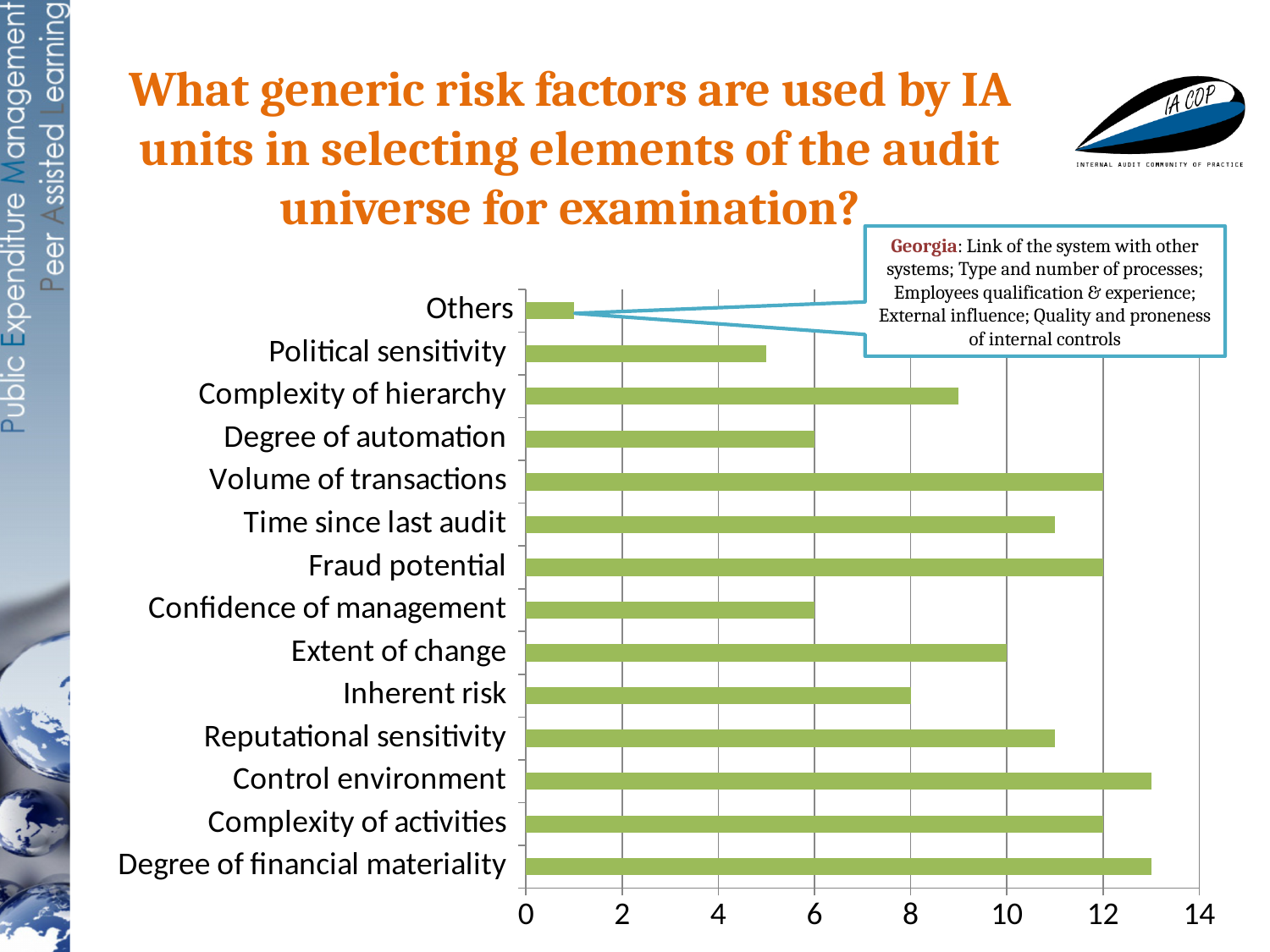
Is the value for Control environment greater or less than 12? greater What kind of chart is shown on the slide? bar chart What is the difference between the values for Volume of transactions and Inherent risk? 4 What is the value for Inherent risk? 8 Which category has the lowest value? Others How many risk factor categories are plotted on the chart? 14 What is the value for Degree of automation? 6 Is the value for Political sensitivity greater or less than 6? less Which country is named in the callout box attached to the Others bar? Georgia Which is larger, the value for Extent of change or the value for Confidence of management? Extent of change What is the value for Extent of change? 10 What is the value for Volume of transactions? 12